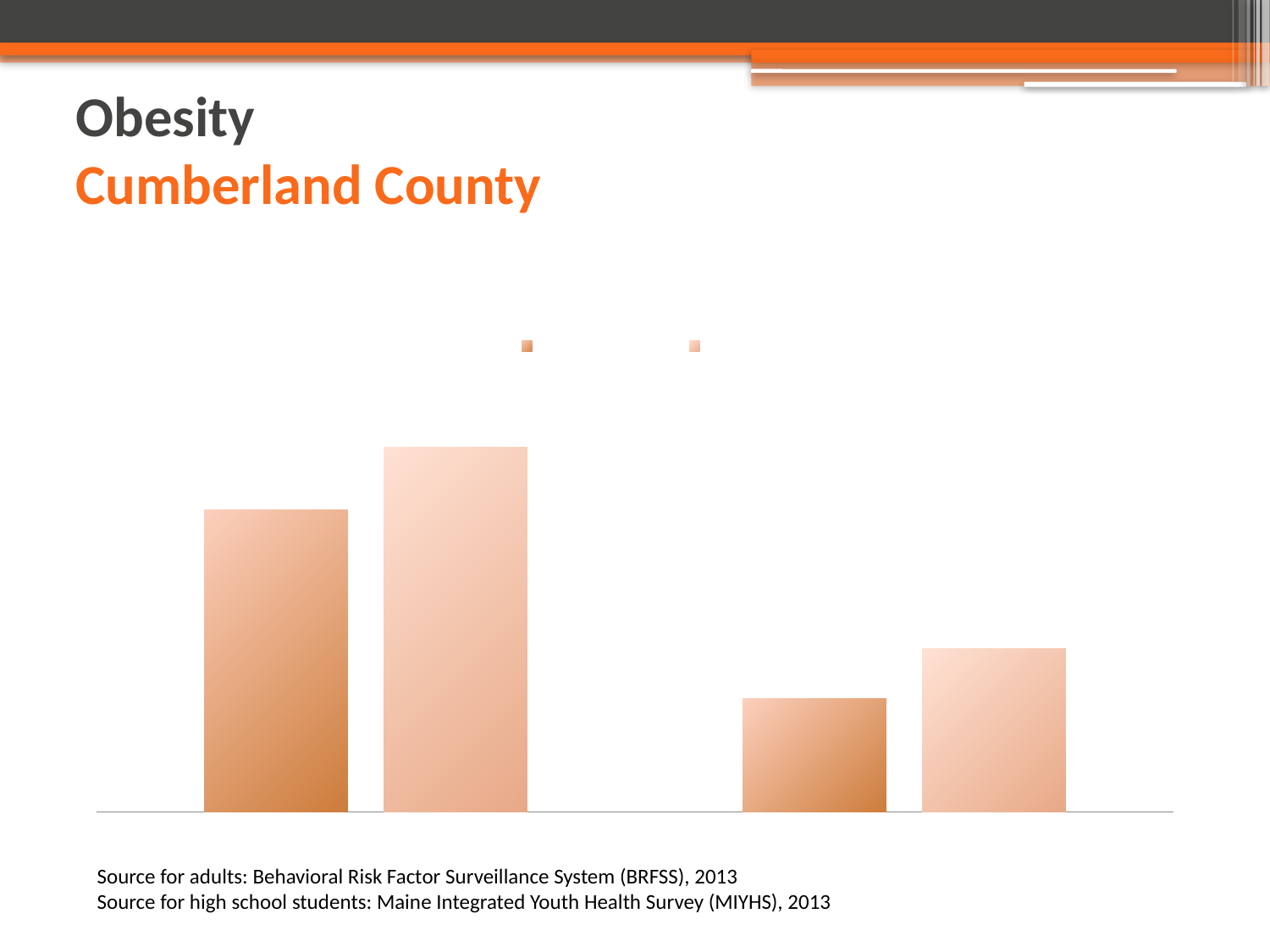
Which bar is the tallest in the chart, counting from the left? the second bar How many bars are plotted in the chart? 4 What colour are the bars in the chart? orange How many series does the chart's legend list? 2 What kind of chart is shown on the slide? bar chart Is the left group of bars taller or shorter than the right group of bars? taller What is the title text shown above the chart on the slide? Obesity Cumberland County Within the right pair of bars, is the lighter bar taller or shorter than the darker bar? taller Is the leftmost bar taller or shorter than the rightmost bar? taller How many groups of bars are shown in the chart? 2 Which bar is the shortest in the chart, counting from the left? the third bar